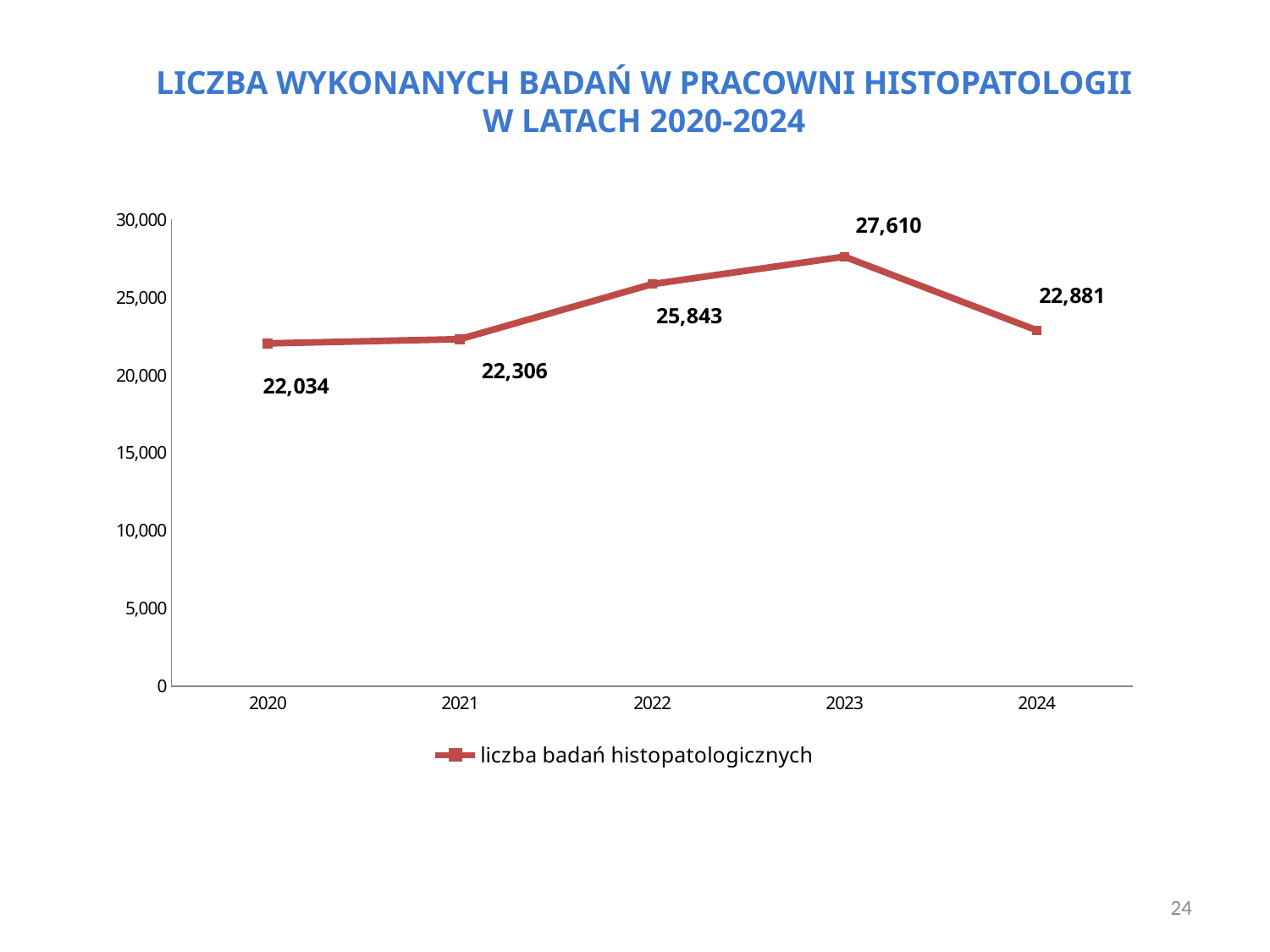
What is the difference between the values for 2023 and 2022? 1,767 Which year has the lowest number of examinations? 2020 How many years are plotted on the chart? 5 What is the difference between the values for 2021 and 2020? 272 Is the value for 2022 greater or less than 25,000? greater What is the number of histopathology examinations in 2020? 22,034 Which year has a larger value, 2022 or 2024? 2022 What is the value for 2023? 27,610 Which year has the highest number of examinations? 2023 What kind of chart is shown on the slide? line chart What is the value for 2024? 22,881 What is the name of the series shown in the legend? liczba badań histopatologicznych